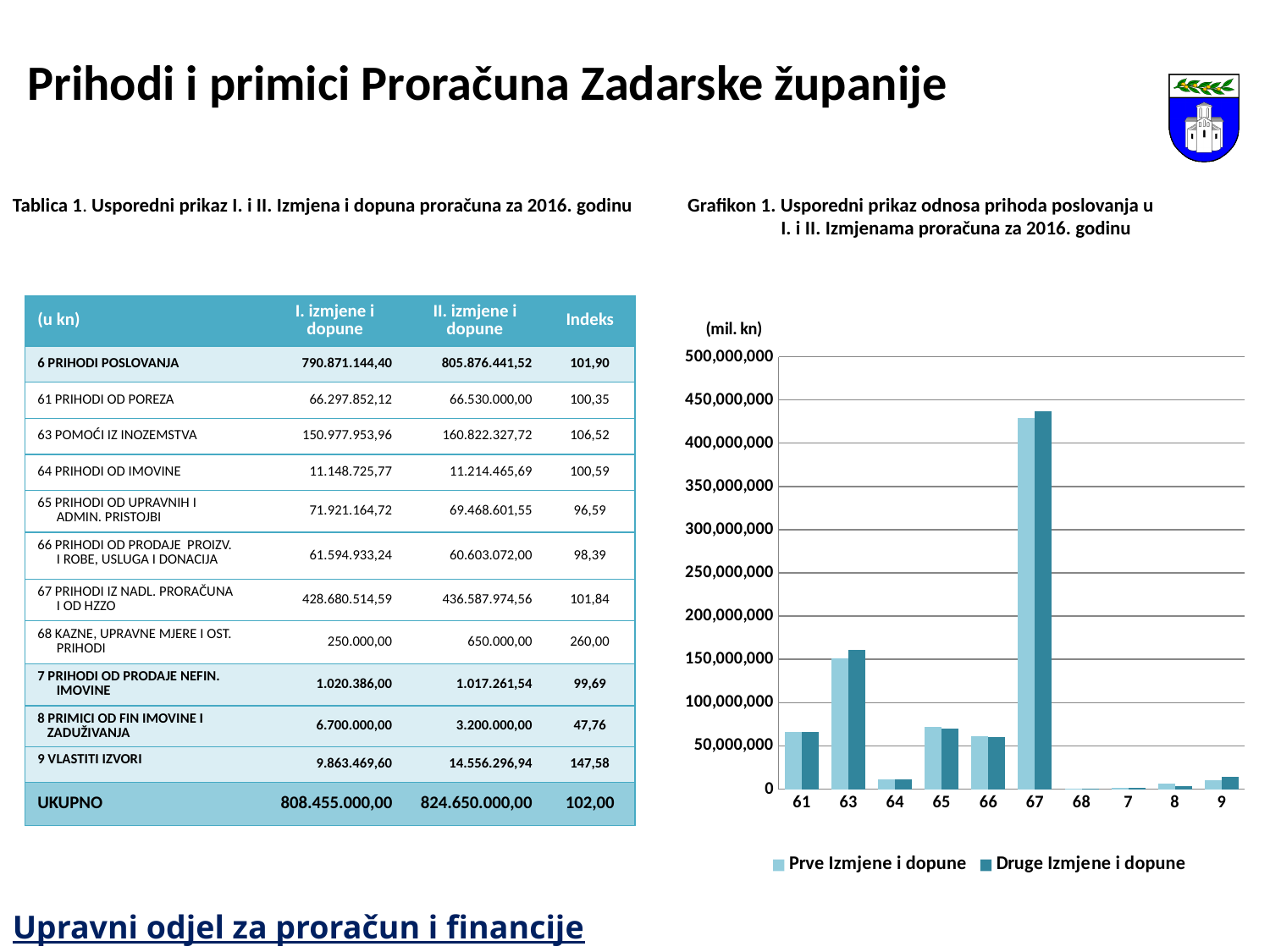
What kind of chart is Grafikon 1? bar chart Which category has the highest bars in the chart? 67 For category 63, which series has the larger bar, Prve Izmjene i dopune or Druge Izmjene i dopune? Druge Izmjene i dopune Is the value for category 67 in the Prve Izmjene i dopune series greater or less than 400,000,000? greater Is the value for category 61 in the Druge Izmjene i dopune series greater or less than 50,000,000? greater How many categories are shown on the x axis of the chart? 10 Is the value for category 64 in the Prve Izmjene i dopune series greater or less than 50,000,000? less Which category has the larger bars in the chart, 63 or 61? 63 What unit label is shown above the chart's vertical axis? (mil. kn) What are the two legend entries of the chart? Prve Izmjene i dopune; Druge Izmjene i dopune How many series does the chart's legend list? 2